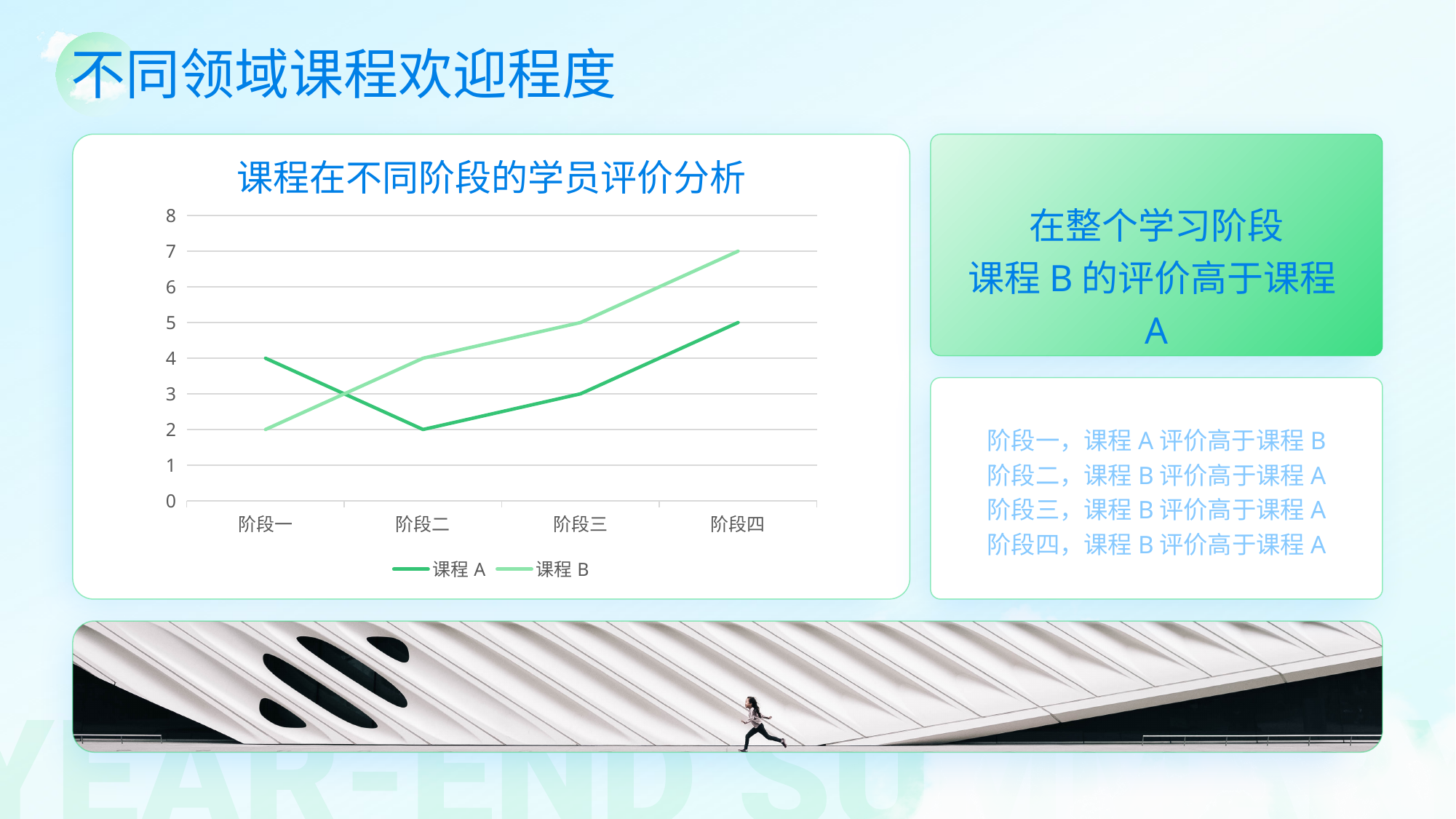
How many stages (categories) are shown on the x axis? 4 What is the title of the chart? 课程在不同阶段的学员评价分析 Does the value for 课程 B rise or fall from 阶段一 to 阶段四? rise What is the value for 课程 A at 阶段一? 4 How many series does the legend list? 2 At 阶段一, which series has the larger value, 课程 A or 课程 B? 课程 A What kind of chart is shown on the slide? line chart At which stage does 课程 A have its lowest value? 阶段二 What is the difference between 课程 B and 课程 A at 阶段四? 2 What is the value for 课程 A at 阶段二? 2 What is the value for 课程 B at 阶段四? 7 At which stage does 课程 B reach its highest value? 阶段四